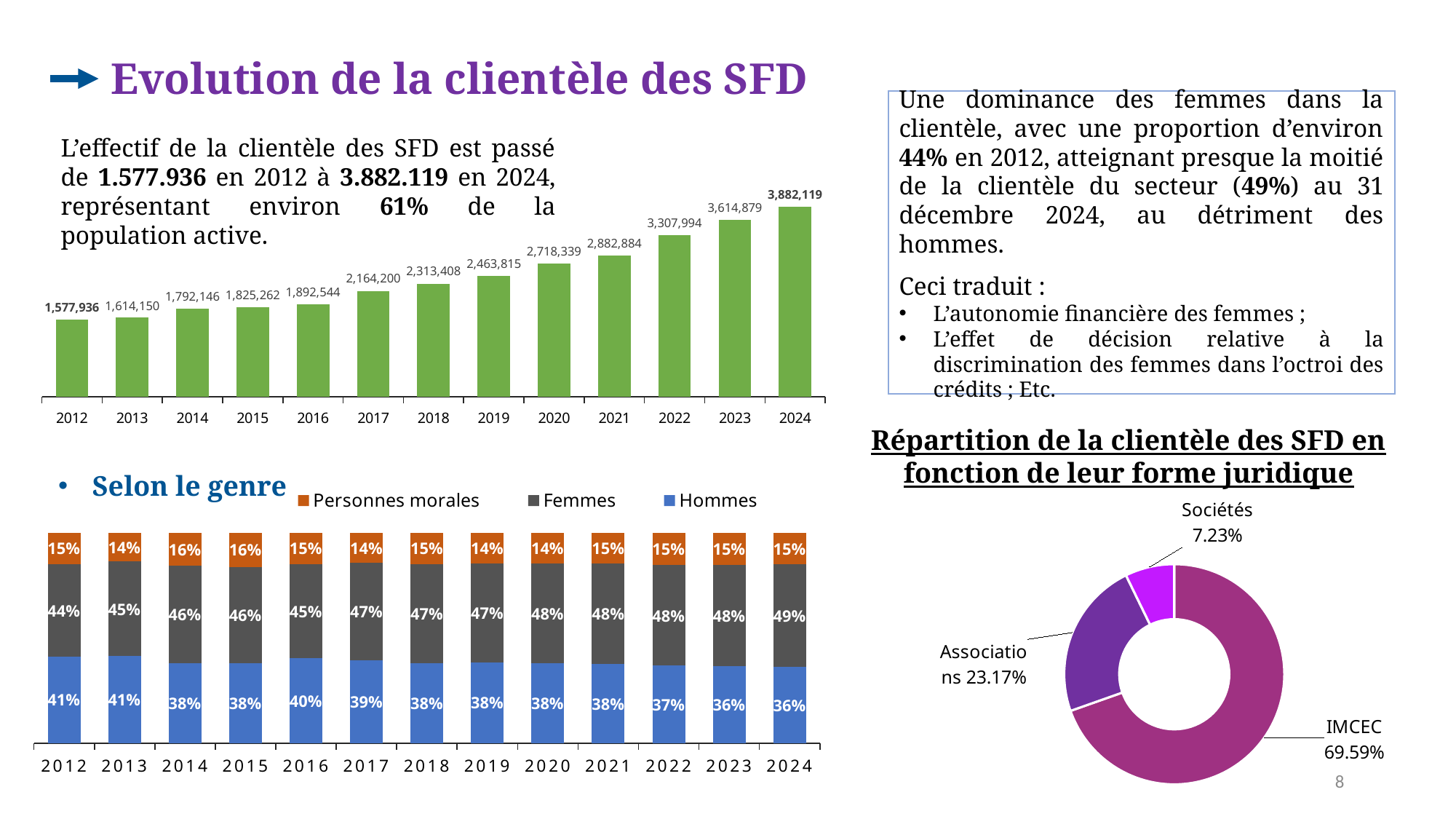
In the 'Selon le genre' stacked bar chart, which is larger in 2024: the Femmes share or the Hommes share? Femmes In the top-left bar chart of SFD clientele, what is the difference between the 2024 and 2023 values? 267,240 In the top-left bar chart of SFD clientele, what is the value for 2018? 2,313,408 In the top-left bar chart of SFD clientele, how many years are shown on the x axis? 13 In the top-left bar chart of SFD clientele, which year has the lowest value? 2012 In the 'Selon le genre' stacked bar chart, what is the Femmes share in 2024? 49% In the top-left bar chart of SFD clientele, do the values rise or fall from 2012 to 2024? rise In the 'Répartition de la clientèle des SFD en fonction de leur forme juridique' chart, what is the share for Associations? 23.17% In the 'Selon le genre' stacked bar chart, how many series does the legend list? 3 In the top-left bar chart of SFD clientele, which year has the highest value? 2024 What kind of chart is the 'Répartition de la clientèle des SFD en fonction de leur forme juridique' chart? doughnut chart In the 'Selon le genre' stacked bar chart, what is the Hommes share in 2012? 41%